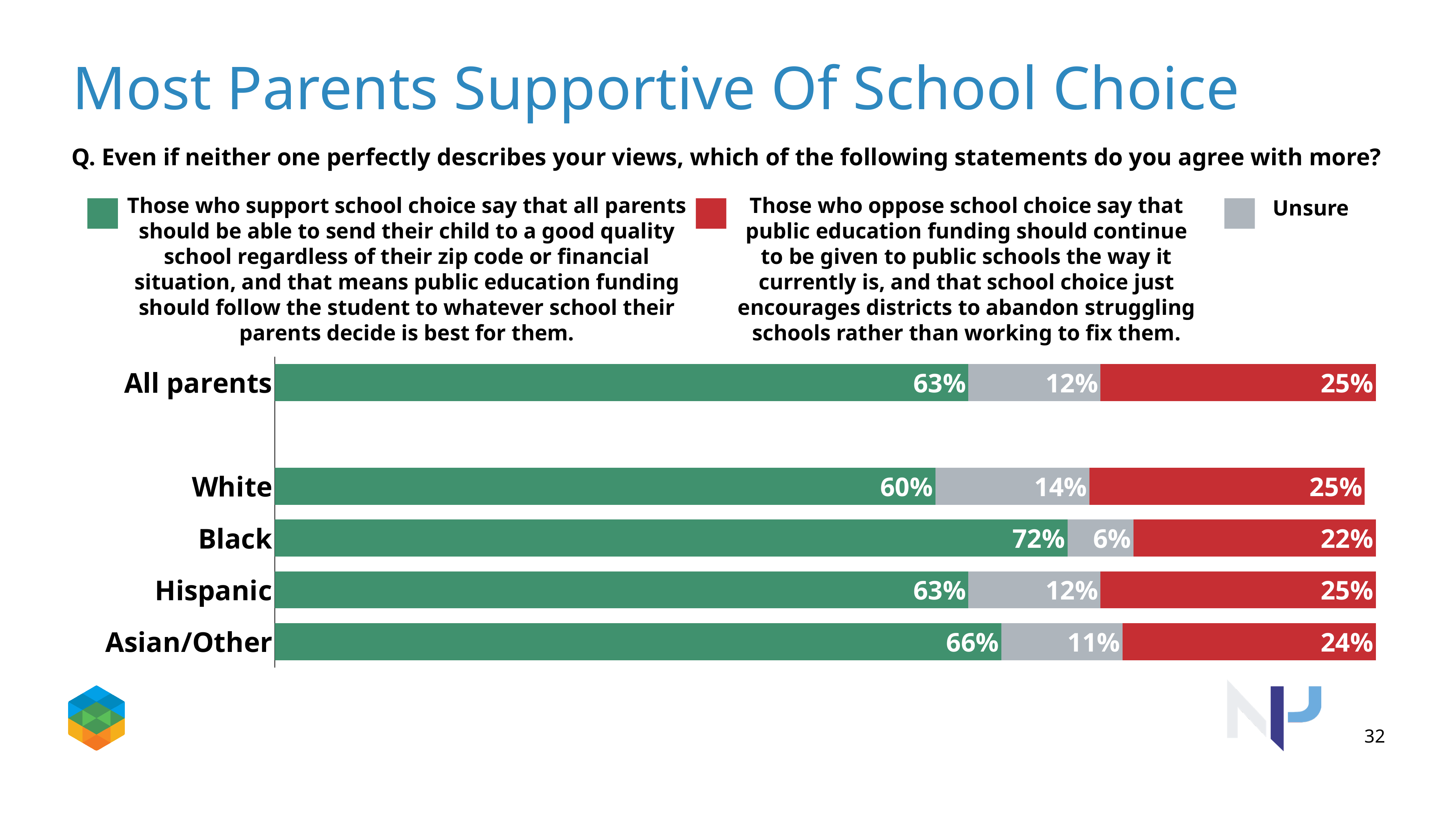
Which group has the lowest percentage supporting school choice (green segment)? White Which group has the highest Unsure percentage? White Which is larger: the Unsure percentage for Hispanic parents or for Asian/Other parents? Hispanic How many groups are shown on the chart? 5 What percentage of All parents support school choice (green segment)? 63% What kind of chart is shown on the slide? Stacked bar chart What percentage of Black parents are Unsure? 6% What percentage of Asian/Other parents support school choice (green segment)? 66% What percentage of White parents oppose school choice (red segment)? 25% Which group has the highest percentage supporting school choice (green segment)? Black How many series does the legend list? 3 What is the difference between the support percentage for Black parents and White parents? 12 percentage points